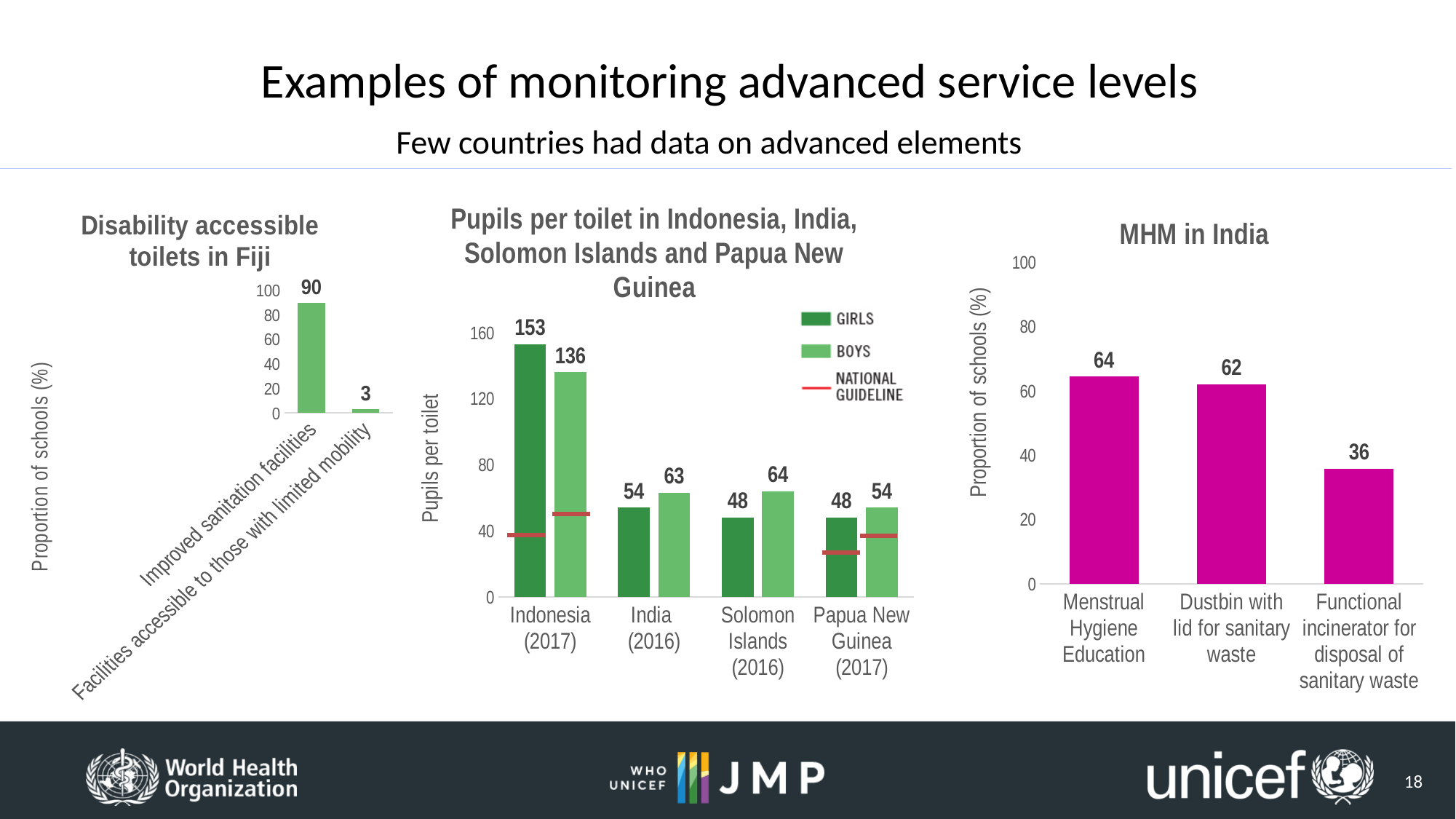
In the 'Pupils per toilet' chart, what is the value for boys in India (2016)? 63 In the 'Pupils per toilet' chart, which country has the highest value for girls? Indonesia (2017) In the 'Pupils per toilet' chart, how many series does the legend list? 3 In the 'Disability accessible toilets in Fiji' chart, what is the value for 'Improved sanitation facilities'? 90 In the 'Disability accessible toilets in Fiji' chart, what is the difference between the two bars? 87 What kind of chart is the 'MHM in India' chart? bar chart In the 'Disability accessible toilets in Fiji' chart, what is the value for 'Facilities accessible to those with limited mobility'? 3 In the 'Pupils per toilet' chart, what is the difference between the girls and boys values for Indonesia (2017)? 17 In the 'MHM in India' chart, which category has the lowest value? Functional incinerator for disposal of sanitary waste In the 'Pupils per toilet' chart, is the boys value for Solomon Islands (2016) larger or smaller than the girls value? larger In the 'MHM in India' chart, what is the value for 'Functional incinerator for disposal of sanitary waste'? 36 In the 'Pupils per toilet' chart, what is the value for girls in Indonesia (2017)? 153